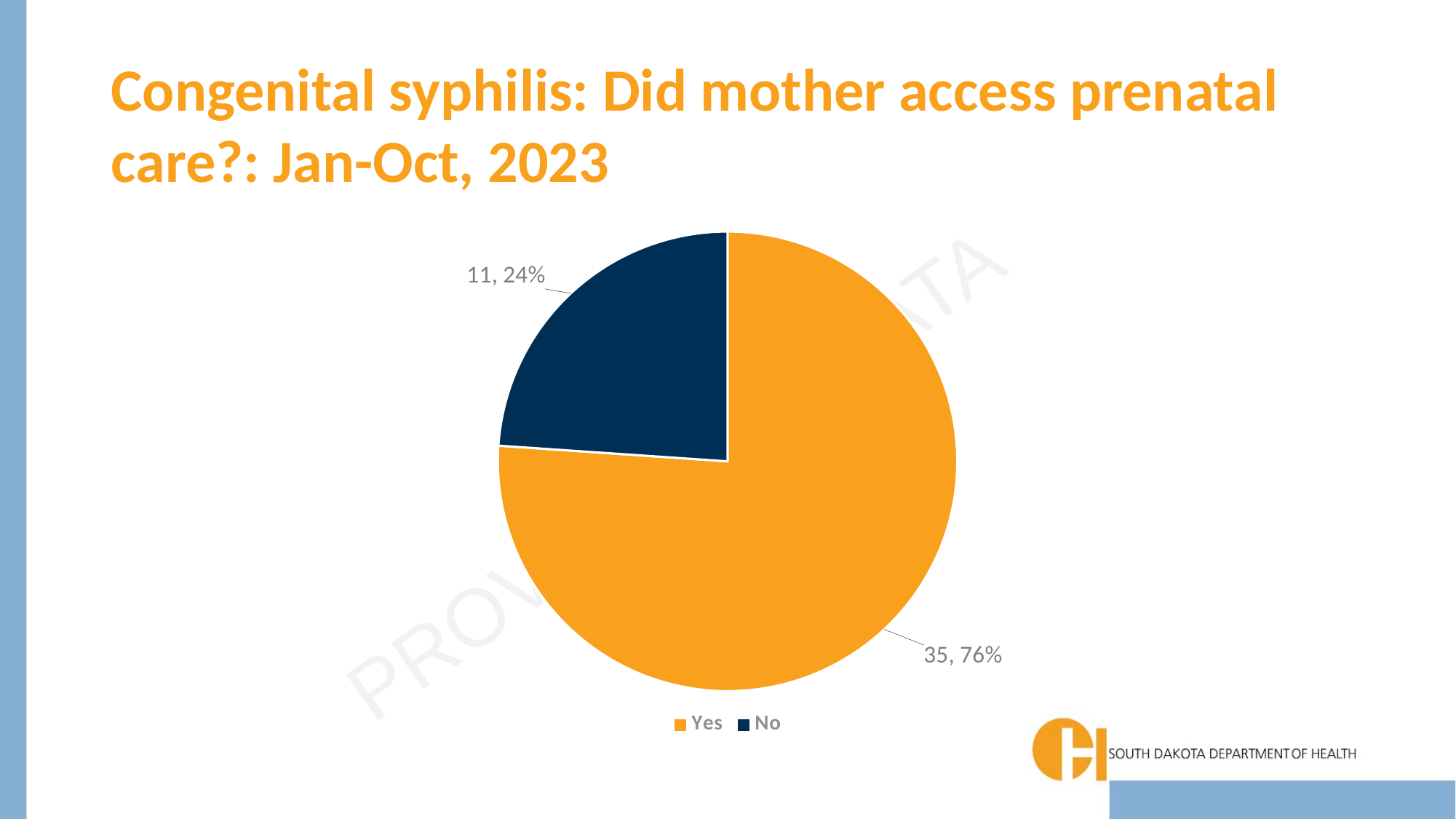
What colour is the No slice? dark blue Which slice is the largest? Yes What kind of chart is shown on the slide? pie chart How many slices does the pie chart have? 2 Which is larger, the Yes slice or the No slice? Yes What percentage of the pie is the Yes slice? 76% What is the count for the Yes slice? 35 How many entries does the legend list? 2 What is the count for the No slice? 11 What is the difference in count between the Yes and No slices? 24 What percentage of the pie is the No slice? 24% Which slice is the smallest? No